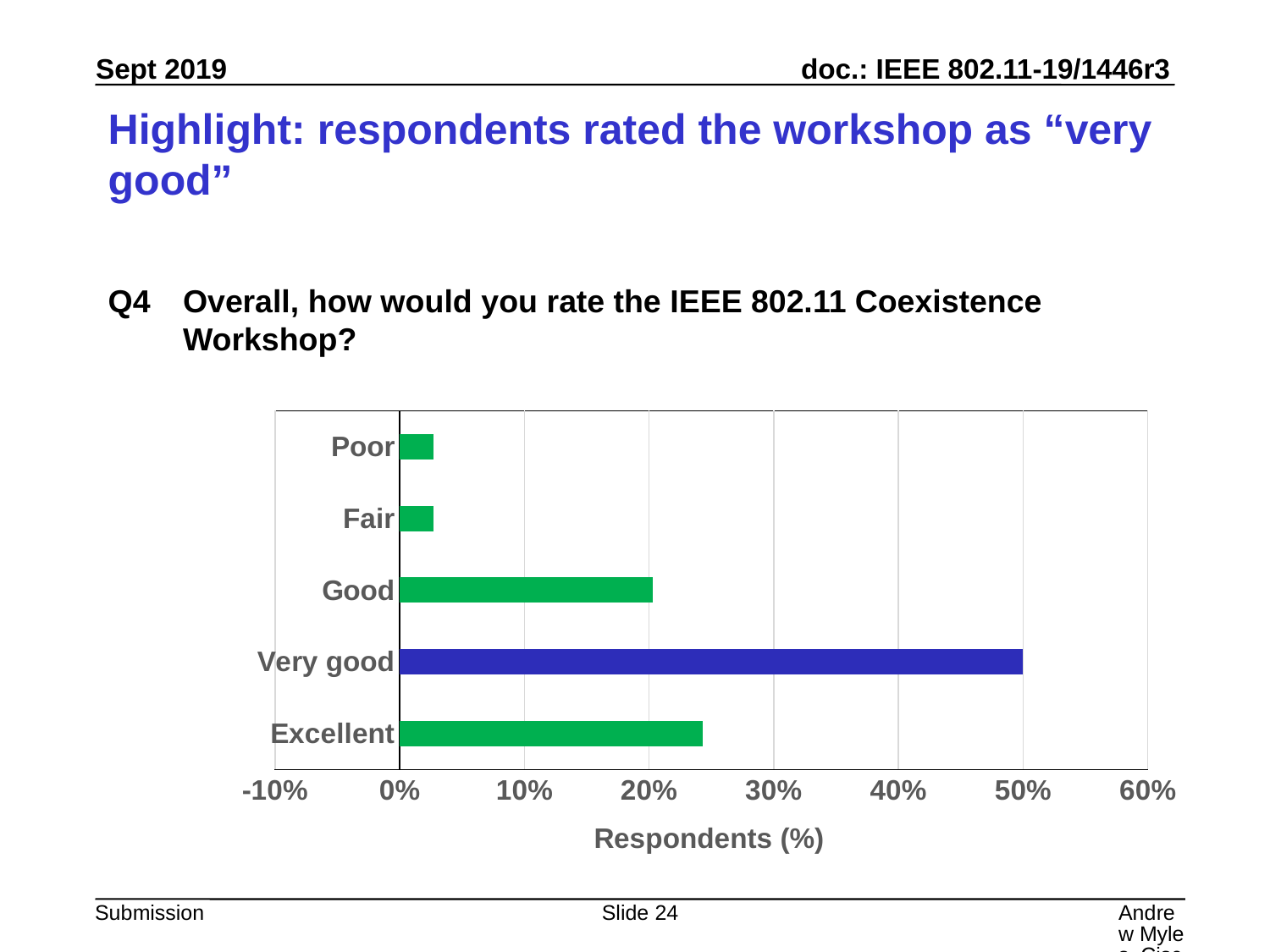
Is the value for Good greater or less than 30%? less Is the value for Very good greater or less than 40%? greater Which is larger, the value for Excellent or the value for Good? Excellent Which rating category's bar is coloured blue rather than green? Very good Is the value for Poor greater or less than 10%? less How many rating categories are plotted on the chart? 5 What kind of chart is shown on the slide? bar chart Which rating category has the highest share of respondents? Very good What is the title of the horizontal axis? Respondents (%) Which is larger, the value for Very good or the value for Excellent? Very good